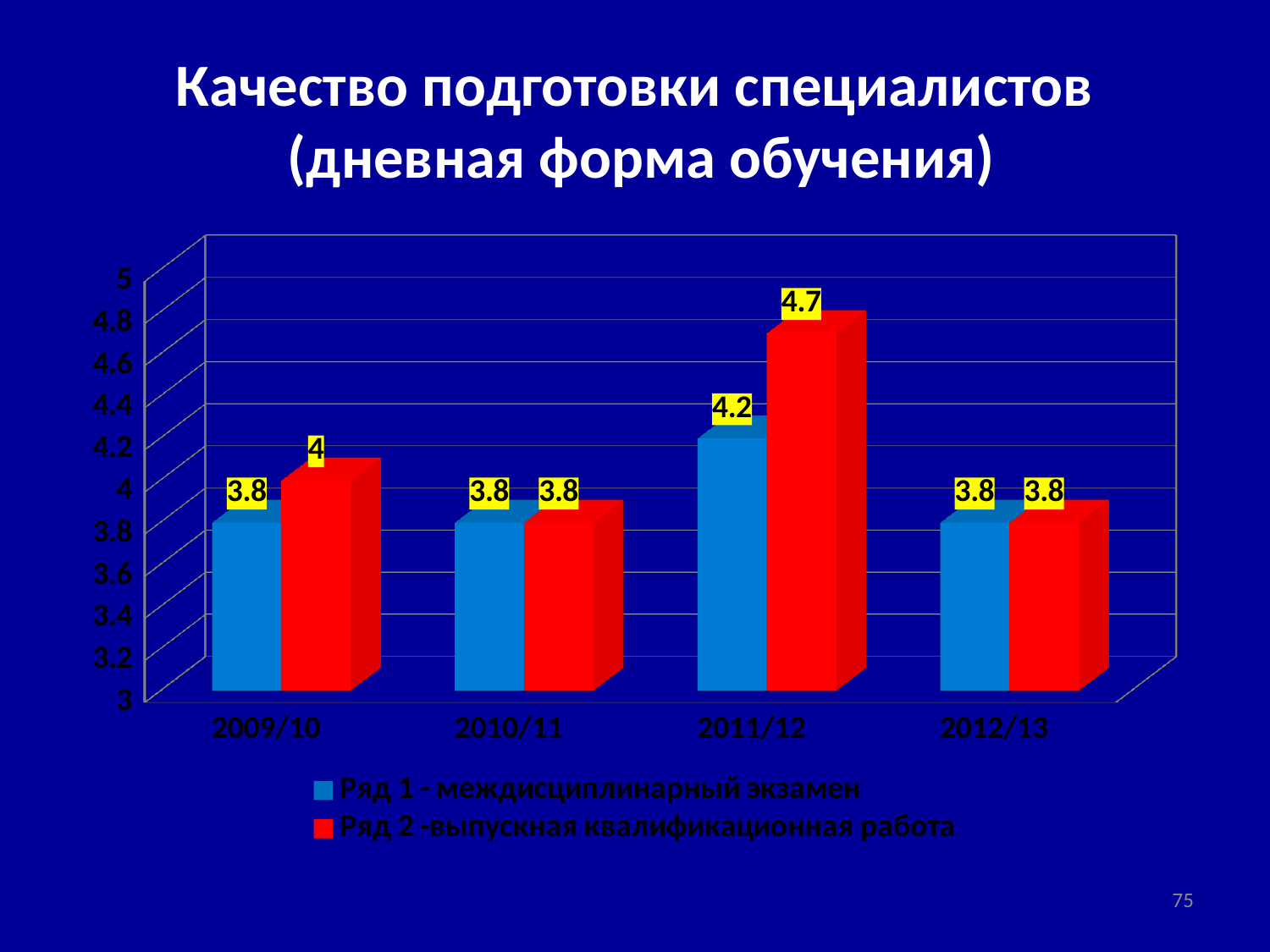
In which year is the value for Ряд 1 - междисциплинарный экзамен highest? 2011/12 What is the value for Ряд 2 - выпускная квалификационная работа in 2011/12? 4.7 What is the difference between Ряд 2 and Ряд 1 in 2009/10? 0.2 What is the value for Ряд 1 - междисциплинарный экзамен in 2012/13? 3.8 How many years are shown on the x axis? 4 Which is larger in 2009/10: Ряд 1 - междисциплинарный экзамен or Ряд 2 - выпускная квалификационная работа? Ряд 2 - выпускная квалификационная работа How many series does the legend list? 2 In which year is the value for Ряд 2 - выпускная квалификационная работа highest? 2011/12 What kind of chart is shown on the slide? Bar chart What is the value for Ряд 2 - выпускная квалификационная работа in 2009/10? 4 What is the value for Ряд 1 - междисциплинарный экзамен in 2011/12? 4.2 What is the difference between Ряд 2 and Ряд 1 in 2011/12? 0.5